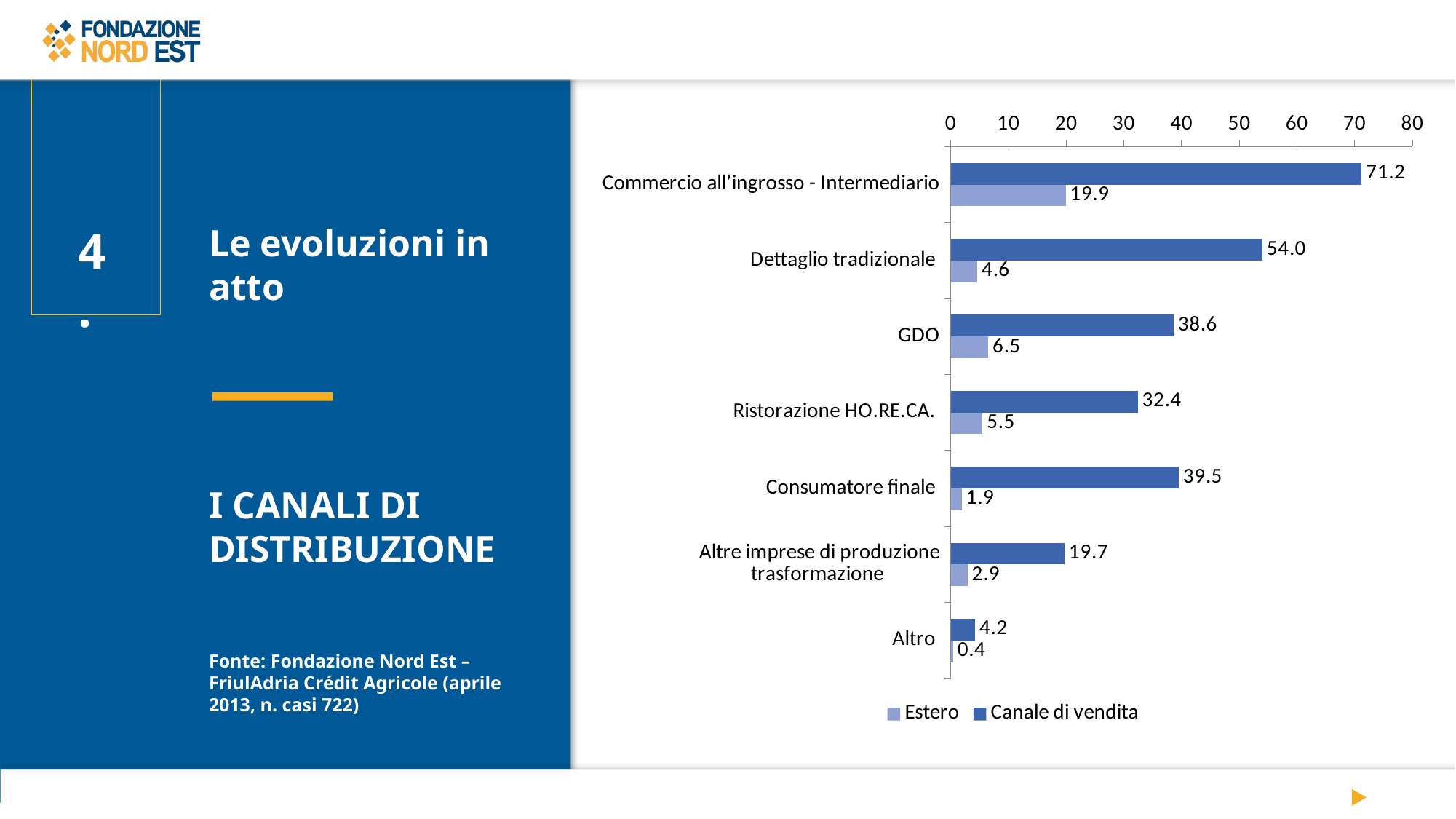
What is the Estero value for GDO? 6.5 Which is larger, the Canale di vendita value for GDO or for Consumatore finale? Consumatore finale What kind of chart is shown on the slide? bar chart What is the Estero value for Altro? 0.4 Which category has the lowest Estero value? Altro How many categories are shown on the chart? 7 Is the Canale di vendita value for Ristorazione HO.RE.CA. greater or less than 30? greater Which series is shown in the lighter blue colour? Estero What is the Canale di vendita value for Commercio all'ingrosso - Intermediario? 71.2 Which category has the highest Canale di vendita value? Commercio all'ingrosso - Intermediario How many series does the legend list? 2 What is the difference between the Canale di vendita and Estero values for Dettaglio tradizionale? 49.4